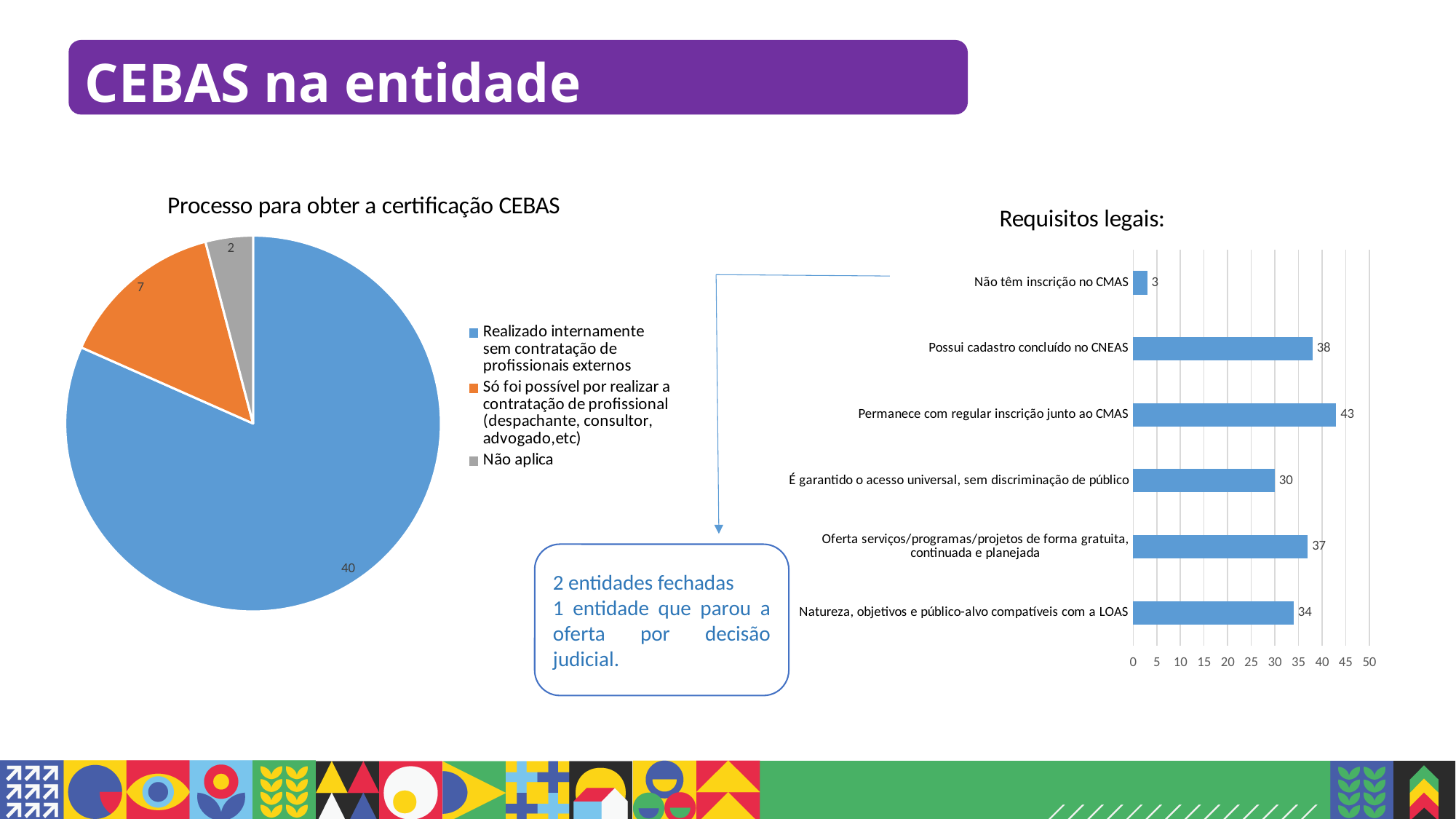
In the 'Requisitos legais' chart, which category has the lowest value? Não têm inscrição no CMAS In the 'Requisitos legais' chart, which is larger: 'É garantido o acesso universal, sem discriminação de público' or 'Oferta serviços/programas/projetos de forma gratuita, continuada e planejada'? Oferta serviços/programas/projetos de forma gratuita, continuada e planejada In the 'Requisitos legais' chart, what is the value for 'Permanece com regular inscrição junto ao CMAS'? 43 In the pie chart 'Processo para obter a certificação CEBAS', what is the value for 'Não aplica'? 2 In the pie chart 'Processo para obter a certificação CEBAS', which colour is the 'Não aplica' slice? Grey In the 'Requisitos legais' chart, what is the value for 'Não têm inscrição no CMAS'? 3 What kind of chart is the 'Requisitos legais' chart? Bar chart In the 'Requisitos legais' chart, which category has the highest value? Permanece com regular inscrição junto ao CMAS In the pie chart 'Processo para obter a certificação CEBAS', what is the difference between the largest slice (40) and the 'Só foi possível por realizar a contratação de profissional' slice (7)? 33 In the 'Requisitos legais' chart, what is the difference between 'Possui cadastro concluído no CNEAS' and 'Natureza, objetivos e público-alvo compatíveis com a LOAS'? 4 In the pie chart 'Processo para obter a certificação CEBAS', what is the value for 'Realizado internamente sem contratação de profissionais externos'? 40 In the pie chart 'Processo para obter a certificação CEBAS', how many slices are there? 3